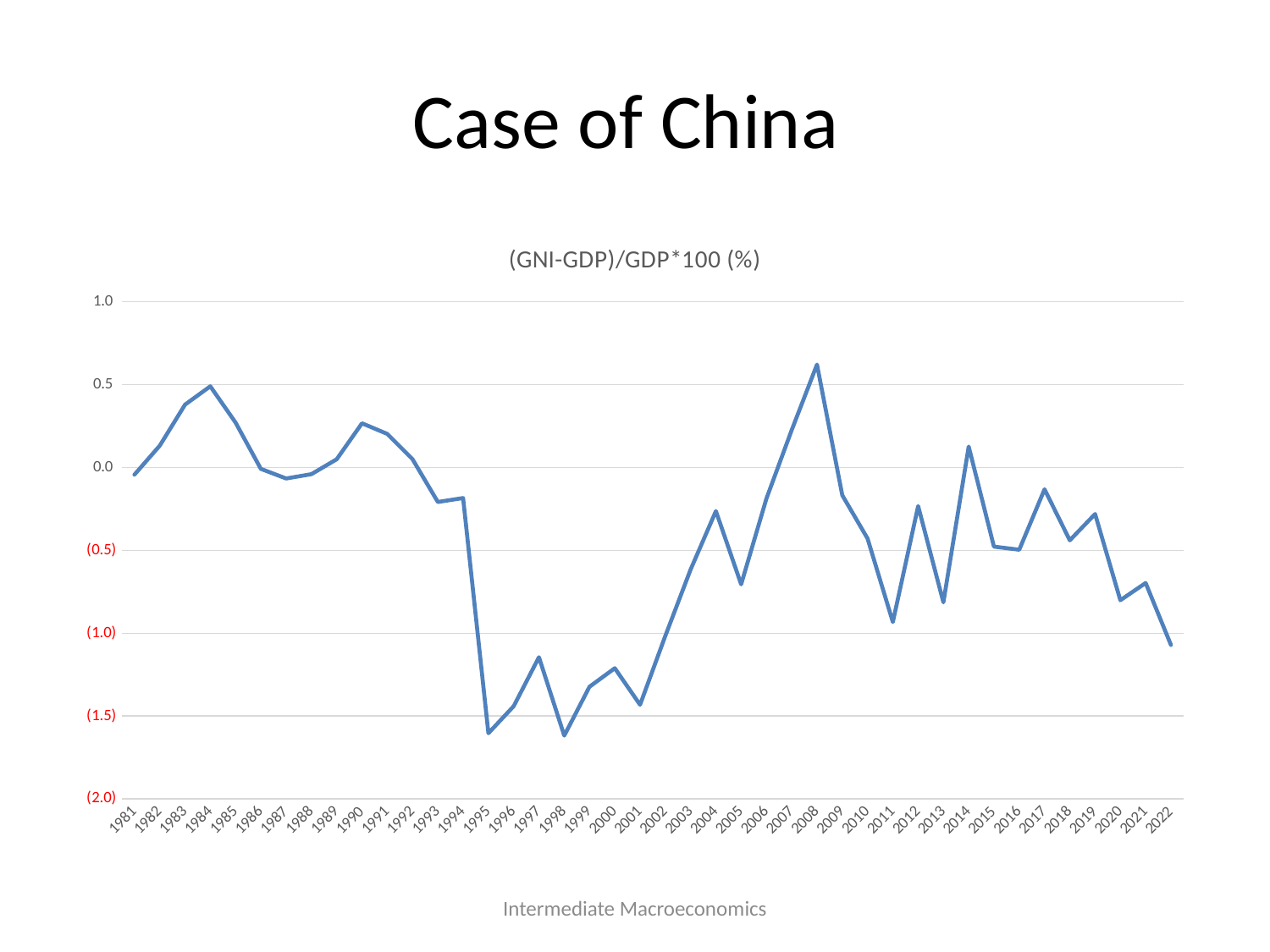
Is the value for 2011 greater or less than (0.5)? less Which year has the larger value, 1995 or 2004? 2004 Which year has the highest value on the chart? 2008 Is the value for 2008 greater or less than 0.5? greater Which year has the larger value, 1984 or 2008? 2008 How many years are plotted along the x axis of the chart? 42 What is the title of the chart? (GNI-GDP)/GDP*100 (%) Is the value for 1995 greater or less than (1.5)? less Does the line rise or fall between 2005 and 2008? rise What kind of chart is shown on the slide? line chart